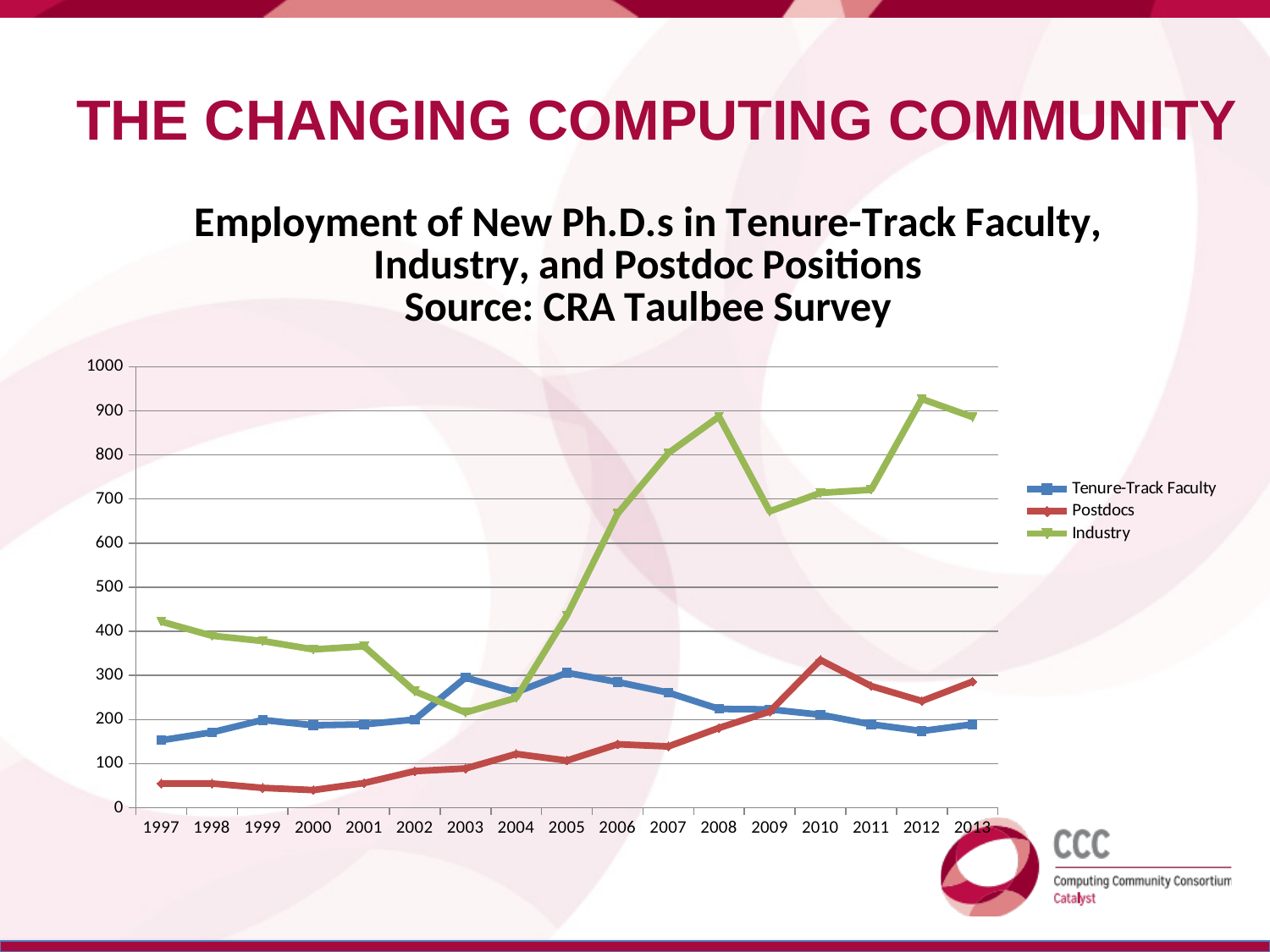
How many series does the legend list? 3 Which series has the lowest value in 1997? Postdocs In which year does the Industry series reach its lowest value? 2003 What kind of chart is shown on the slide? line chart Does the Postdocs series generally rise or fall from 1997 to 2010? rise Which series has the highest value in 2013? Industry How many years are plotted along the x axis? 17 Is the value for Postdocs in 1997 greater or less than 100? less In 2010, which is larger: Postdocs or Tenure-Track Faculty? Postdocs Is the value for Industry in 2012 greater or less than 900? greater In which year does the Industry series reach its highest value? 2012 Is the value for Industry in 2008 greater or less than 800? greater